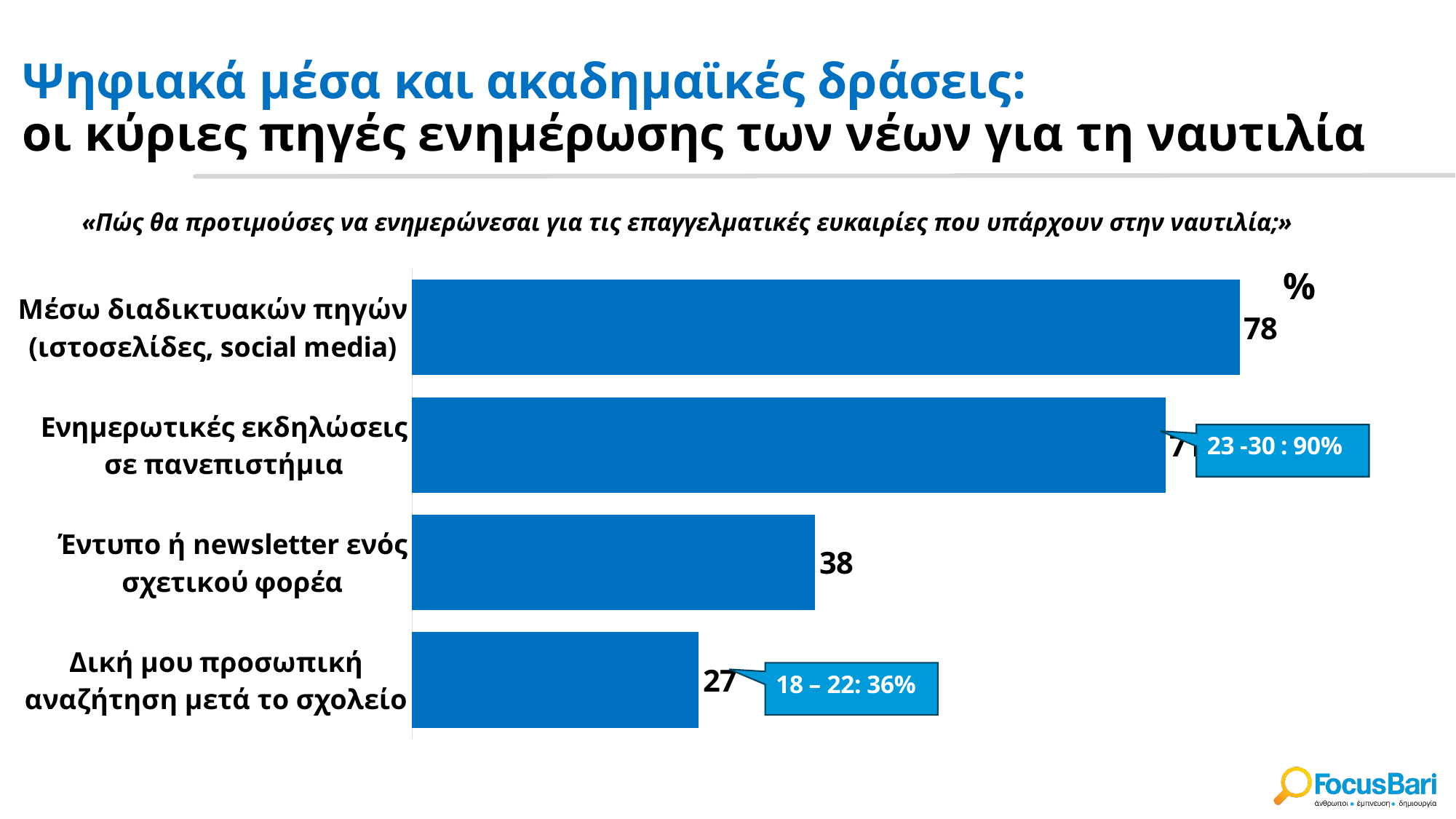
What does the callout next to the «Ενημερωτικές εκδηλώσεις σε πανεπιστήμια» bar say? 23 -30 : 90% Which is larger: the value for «Ενημερωτικές εκδηλώσεις σε πανεπιστήμια» or for «Έντυπο ή newsletter ενός σχετικού φορέα»? Ενημερωτικές εκδηλώσεις σε πανεπιστήμια What is the value for «Μέσω διαδικτυακών πηγών (ιστοσελίδες, social media)»? 78 What is the difference between the values for «Μέσω διαδικτυακών πηγών» and «Έντυπο ή newsletter ενός σχετικού φορέα»? 40 What is the value for «Έντυπο ή newsletter ενός σχετικού φορέα»? 38 What is the value for «Δική μου προσωπική αναζήτηση μετά το σχολείο»? 27 Which category has the lowest value? Δική μου προσωπική αναζήτηση μετά το σχολείο Which category has the highest value? Μέσω διαδικτυακών πηγών (ιστοσελίδες, social media) How many categories are shown in the chart? 4 What kind of chart is shown on the slide? Bar chart What does the callout next to the «Δική μου προσωπική αναζήτηση μετά το σχολείο» bar say? 18 – 22: 36% What is the difference between the values for «Έντυπο ή newsletter ενός σχετικού φορέα» and «Δική μου προσωπική αναζήτηση μετά το σχολείο»? 11